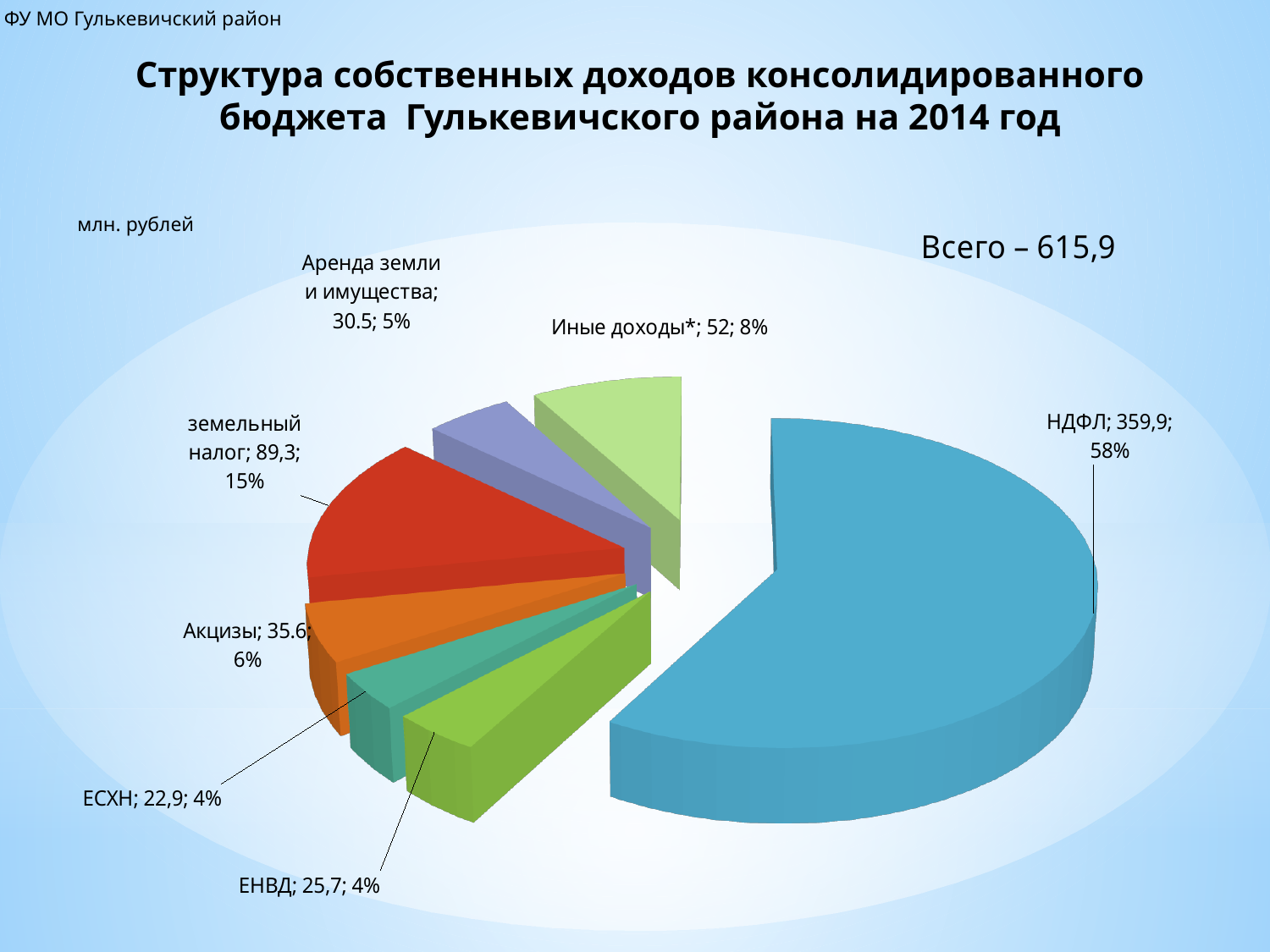
Which is larger, the value for Акцизы or the value for ЕНВД? Акцизы What is the value for ЕСХН? 22,9 What is the value for Иные доходы*? 52 Which category has the largest slice of the pie? НДФЛ Which category has the smallest value in the pie chart? ЕСХН What kind of chart is shown on the slide? Pie chart What total is stated on the slide for the pie chart? 615,9 What is the value for НДФЛ? 359,9 What is the value for земельный налог? 89,3 How many slices does the pie chart have? 7 What share of the pie does земельный налог represent? 15% What share of the pie does Акцизы represent? 6%